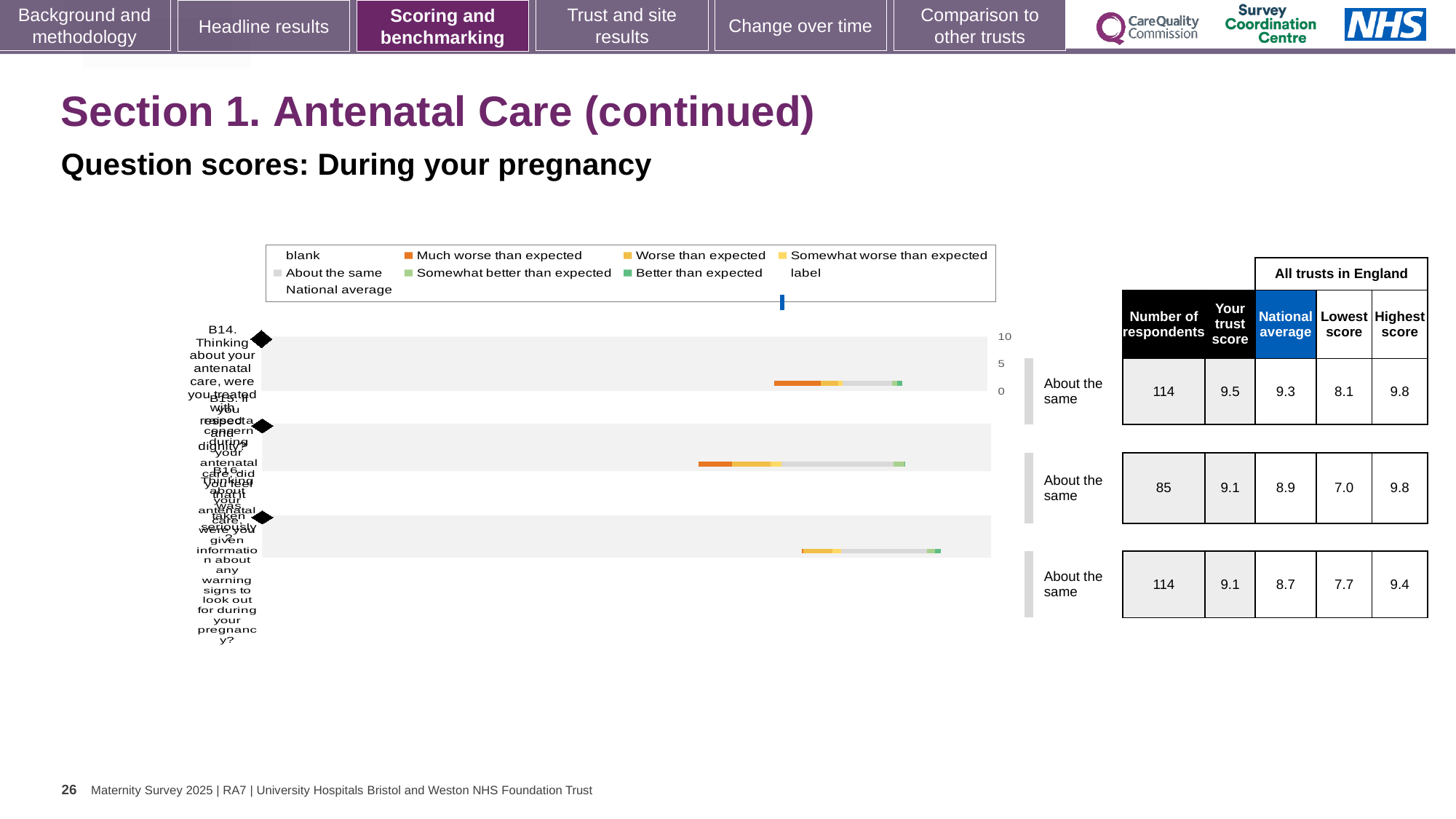
In the table beside the chart, is the trust score in the middle row larger or smaller than the national average in that row? larger In the table beside the chart, what is the national average for the bottom row? 8.7 Which legend entry is shown in dark orange? Much worse than expected How many question rows (bars) are plotted in the chart? 3 How many entries does the chart legend list? 9 What is the highest value shown on the chart's numeric axis? 10 In the table beside the chart, which row has the highest 'Your trust score'? the top row (9.5) In the table beside the chart, what is the trust score for the middle row? 9.1 In the table beside the chart, what is the lowest value in the 'Lowest score' column? 7.0 In the table beside the chart, what is the difference between the trust score and the national average in the top row? 0.2 In the table beside the chart, what is the number of respondents for the top row? 114 What kind of chart is shown on the slide? bar chart